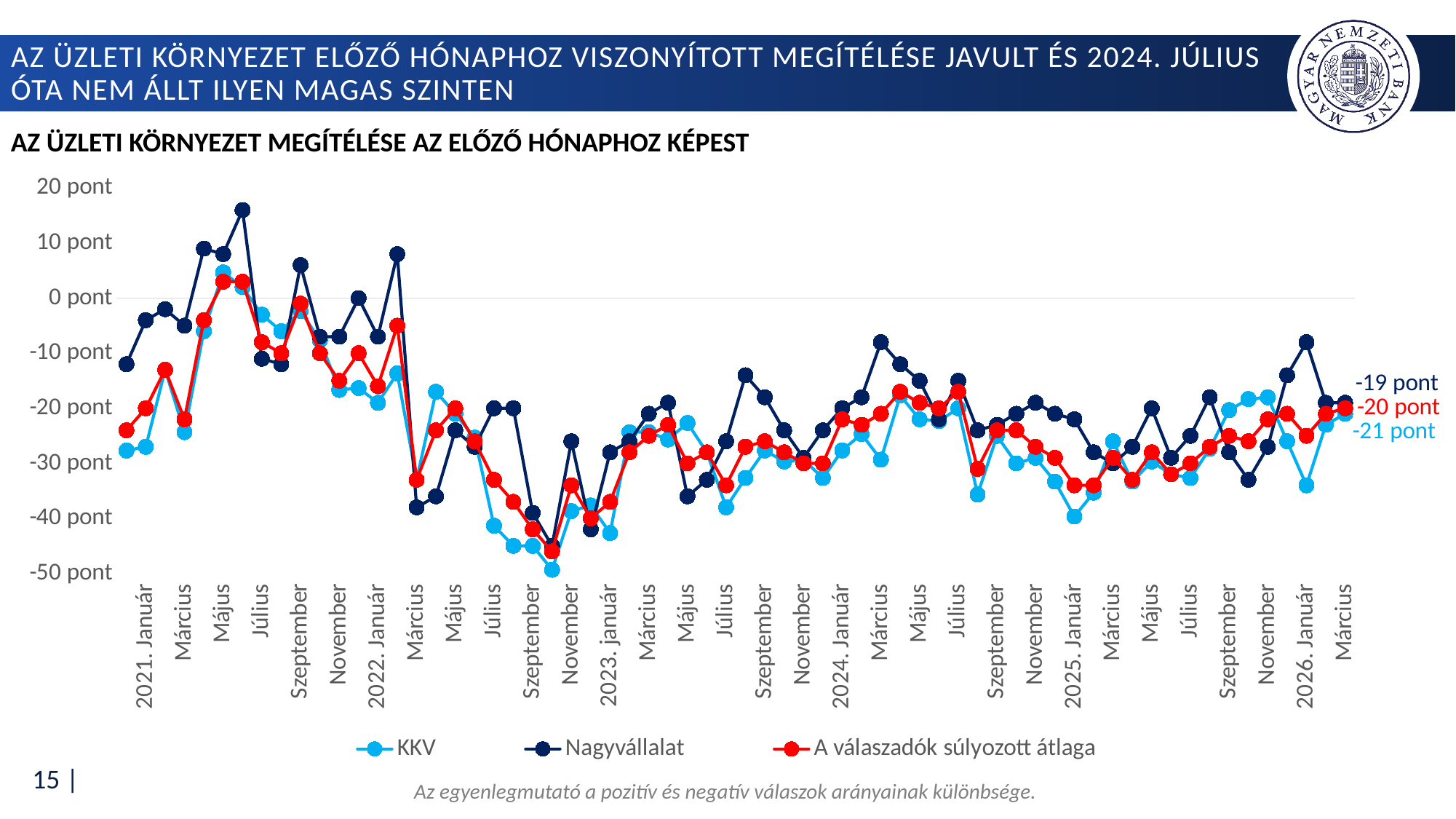
Which series has the lowest value at the last point (2026 March)? KKV What is the value for Nagyvállalat at the last point (2026 March)? -19 pont What kind of chart is shown on the slide? line chart At the last point (2026 March), which series has the higher value, Nagyvállalat or KKV? Nagyvállalat How many series does the legend list? 3 What is the value for KKV at the last point (2026 March)? -21 pont At the last point (2026 March), what is the difference between the Nagyvállalat value and the KKV value? 2 pont What is the title of the chart? AZ ÜZLETI KÖRNYEZET MEGÍTÉLÉSE AZ ELŐZŐ HÓNAPHOZ KÉPEST Is the value for Nagyvállalat in 2021 July greater or less than 10 pont? less What is the value for A válaszadók súlyozott átlaga at the last point (2026 March)? -20 pont